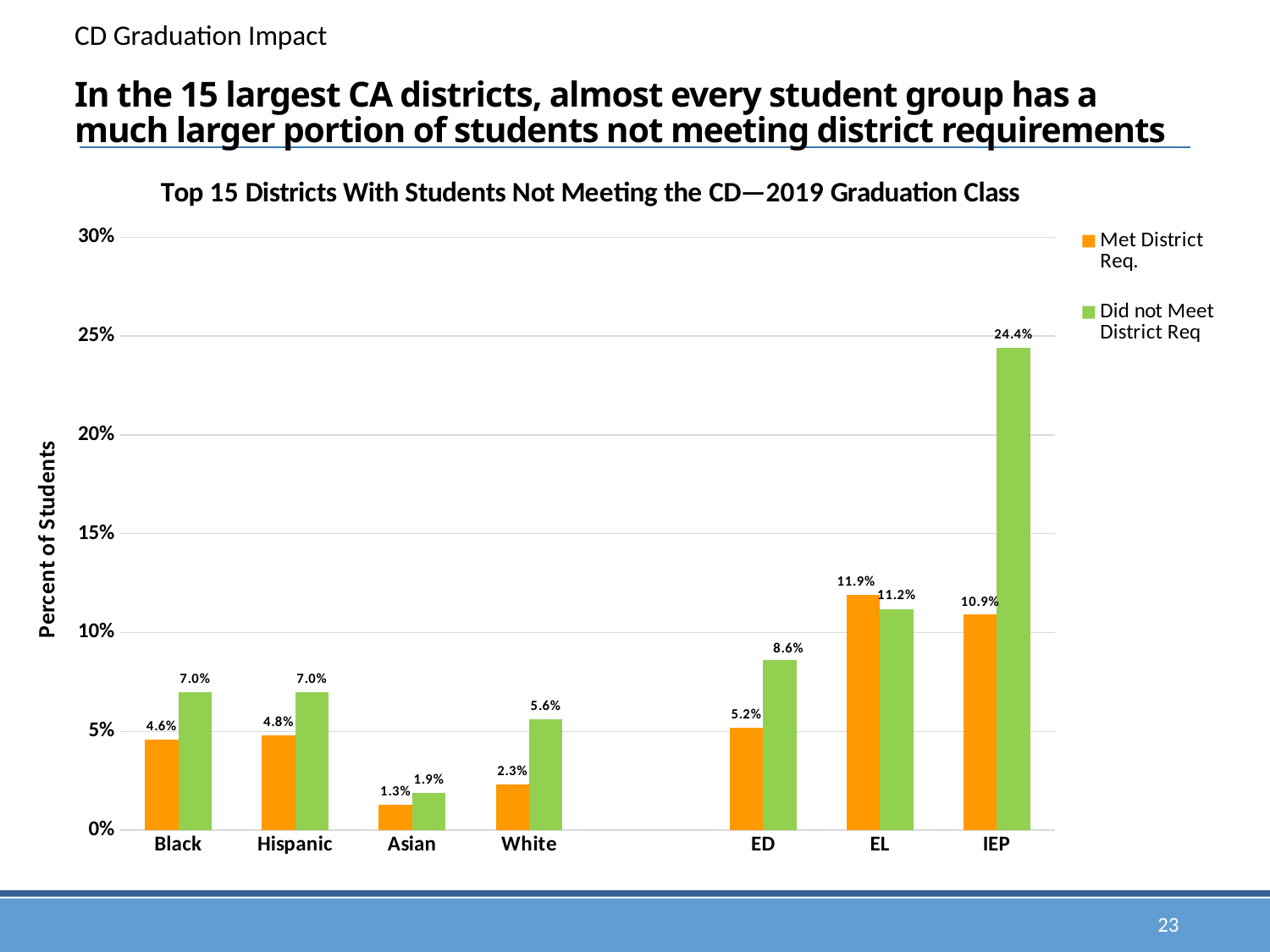
How many series does the legend list? 2 What kind of chart is shown on the slide? Bar chart How many student group categories are shown on the x axis? 7 Is the Did not Meet District Req value for IEP greater or less than 20%? greater Which category has the lowest value in the Met District Req. series? Asian For EL, which is larger: the Met District Req. value or the Did not Meet District Req value? Met District Req. What is the difference between the Did not Meet District Req and Met District Req. values for ED? 3.4% Which category has the highest value in the Did not Meet District Req series? IEP What is the value for White in the Did not Meet District Req series? 5.6% What is the difference between the Did not Meet District Req and Met District Req. values for IEP? 13.5% What is the value for IEP in the Met District Req. series? 10.9% What is the value for Black in the Did not Meet District Req series? 7.0%